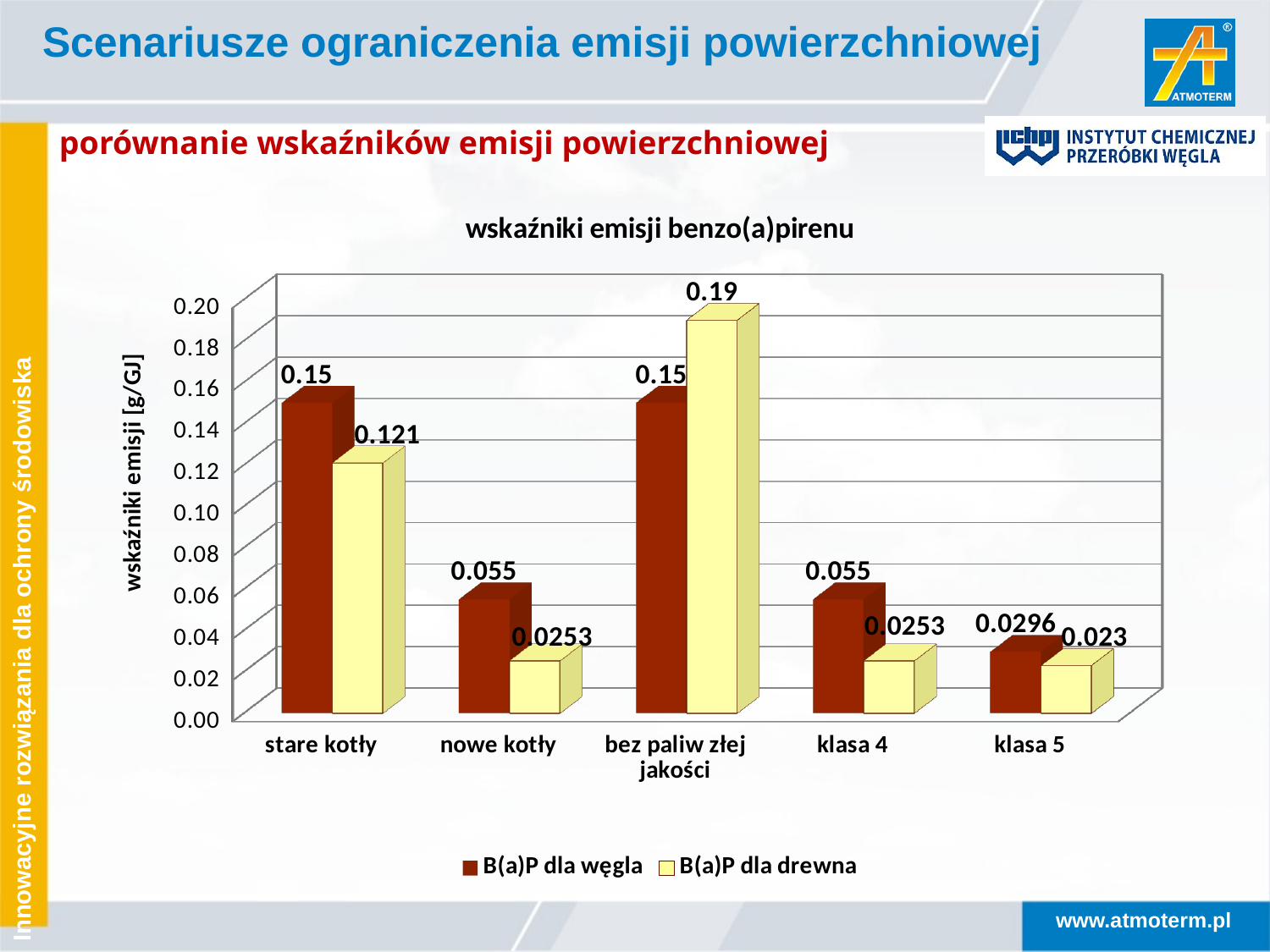
For bez paliw złej jakości, which series has the larger value: B(a)P dla węgla or B(a)P dla drewna? B(a)P dla drewna Which category has the lowest B(a)P dla węgla value? klasa 5 What is the B(a)P dla drewna value for klasa 5? 0.023 What is the difference between the B(a)P dla węgla and B(a)P dla drewna values for stare kotły? 0.029 What is the B(a)P dla drewna value for bez paliw złej jakości? 0.19 Which category has the highest B(a)P dla drewna value? bez paliw złej jakości What is the B(a)P dla węgla value for klasa 4? 0.055 What is the B(a)P dla węgla value for stare kotły? 0.15 What is the title of the chart? wskaźniki emisji benzo(a)pirenu How many categories are shown on the x axis? 5 How many series does the legend list? 2 What kind of chart is shown on the slide? bar chart